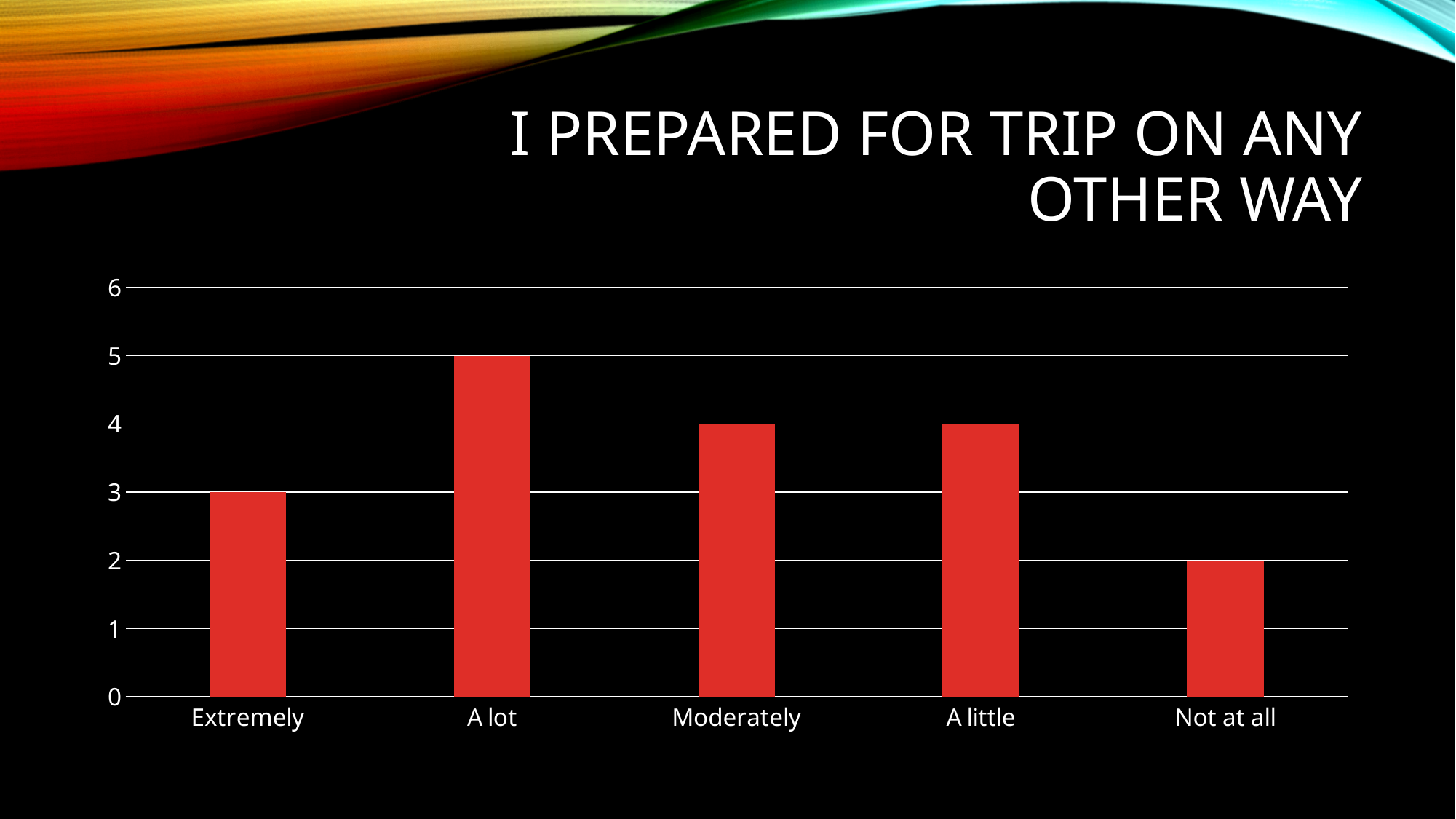
What is the title of the chart on the slide? I prepared for trip on any other way What is the value for "Moderately"? 4 What is the difference between the values for "A lot" and "Not at all"? 3 What is the difference between the values for "Moderately" and "Extremely"? 1 Which category has the highest value? A lot Which is larger, the value for "Extremely" or the value for "A little"? A little How many categories are shown on the x axis? 5 What is the value for "A lot"? 5 What is the value for "Extremely"? 3 Which category has the lowest value? Not at all What is the value for "Not at all"? 2 What kind of chart is shown on the slide? Bar chart